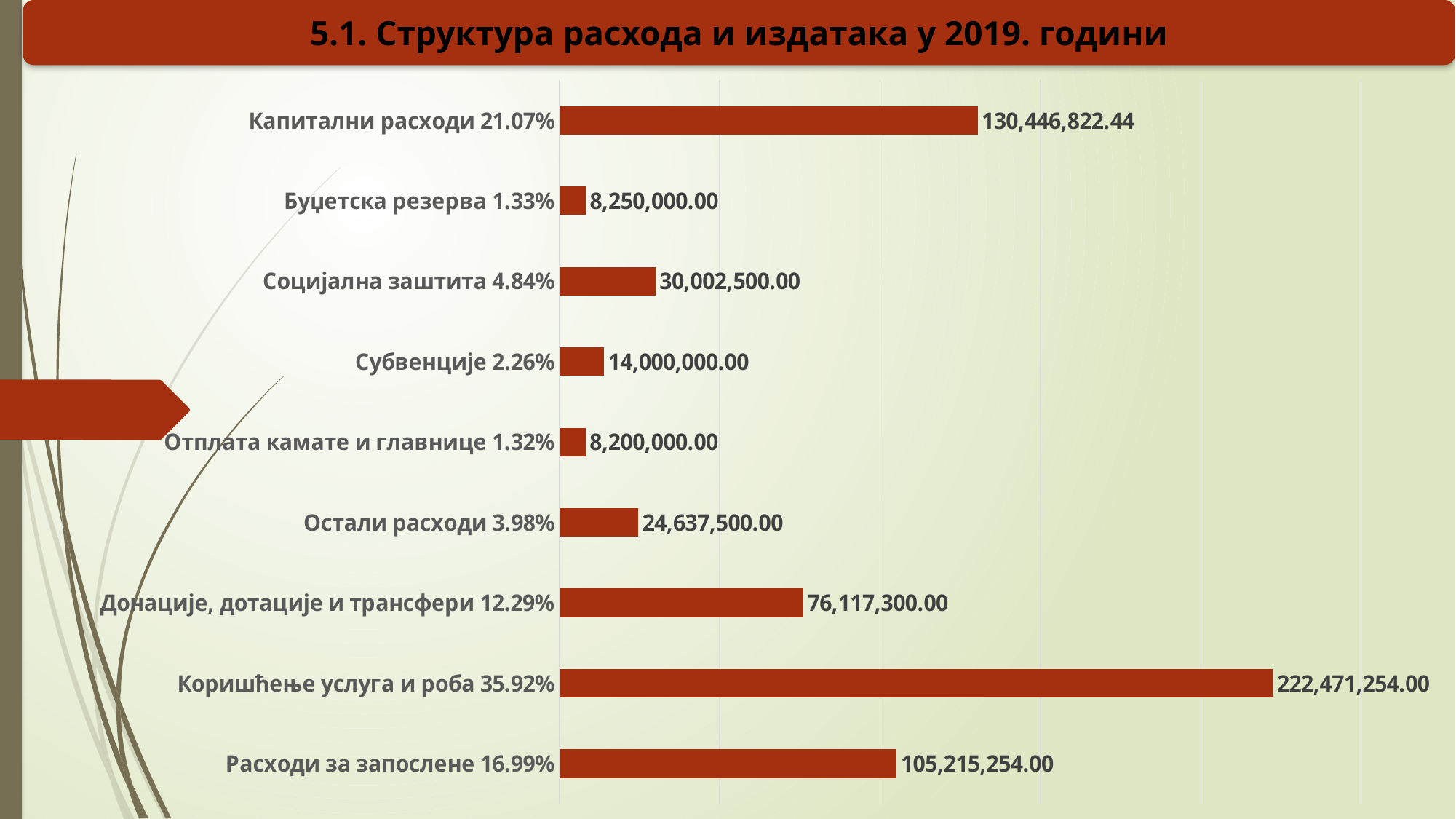
Which is larger, the value for Субвенције or the value for Социјална заштита? Социјална заштита What is the value for Коришћење услуга и роба? 222,471,254.00 What is the value for Донације, дотације и трансфери? 76,117,300.00 What kind of chart is shown on the slide? Bar chart What percentage share is shown in the label for Расходи за запослене? 16.99% Which category has the highest value? Коришћење услуга и роба What is the difference between the values for Социјална заштита and Остали расходи? 5,365,000.00 What is the title of the slide? 5.1. Структура расхода и издатака у 2019. години How many categories are shown in the chart? 9 What is the difference between the values for Коришћење услуга и роба and Расходи за запослене? 117,256,000.00 Which category has the lowest value? Отплата камате и главнице What is the value for Капитални расходи? 130,446,822.44